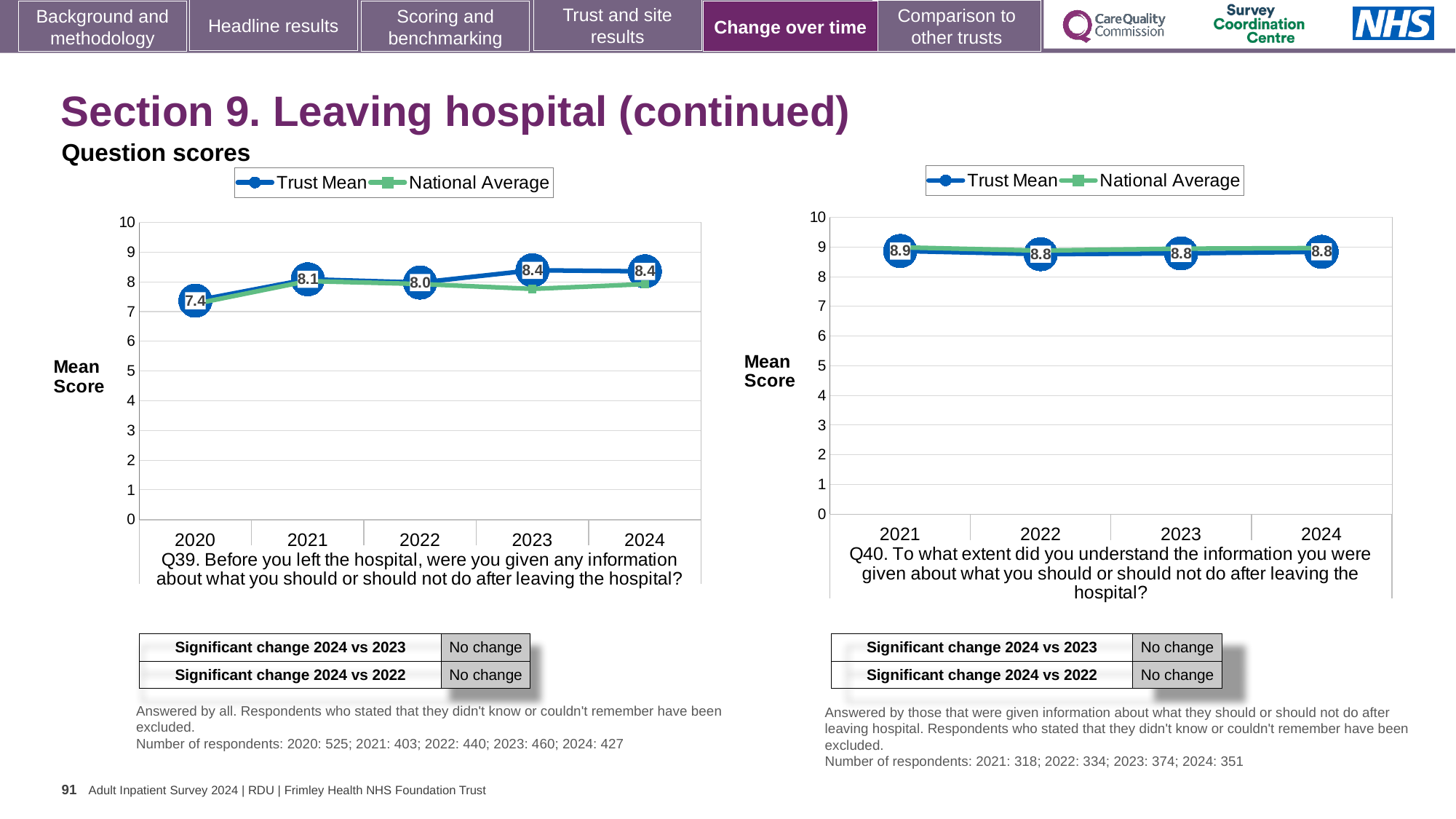
In the Q39 chart on the left, how many years are plotted on the x axis? 5 In the Q40 chart on the right, what is the Trust Mean score for 2021? 8.9 In the Q40 chart on the right, which year has the highest Trust Mean score? 2021 In the Q39 chart on the left, what is the difference between the Trust Mean scores for 2024 and 2020? 1.0 In the Q39 chart on the left, which year has the lowest Trust Mean score? 2020 What type of chart is used for the Q40 chart on the right? Line chart In the Q40 chart on the right, is the National Average for 2022 greater or less than 8? greater In the Q40 chart on the right, how many series does the legend list? 2 In the Q39 chart on the left, what is the Trust Mean score for 2022? 8.0 In the Q39 chart on the left, is the National Average for 2020 greater or less than 8? less In the Q39 chart on the left, is the Trust Mean score higher in 2021 or in 2022? 2021 In the Q39 chart on the left, what is the Trust Mean score for 2020? 7.4